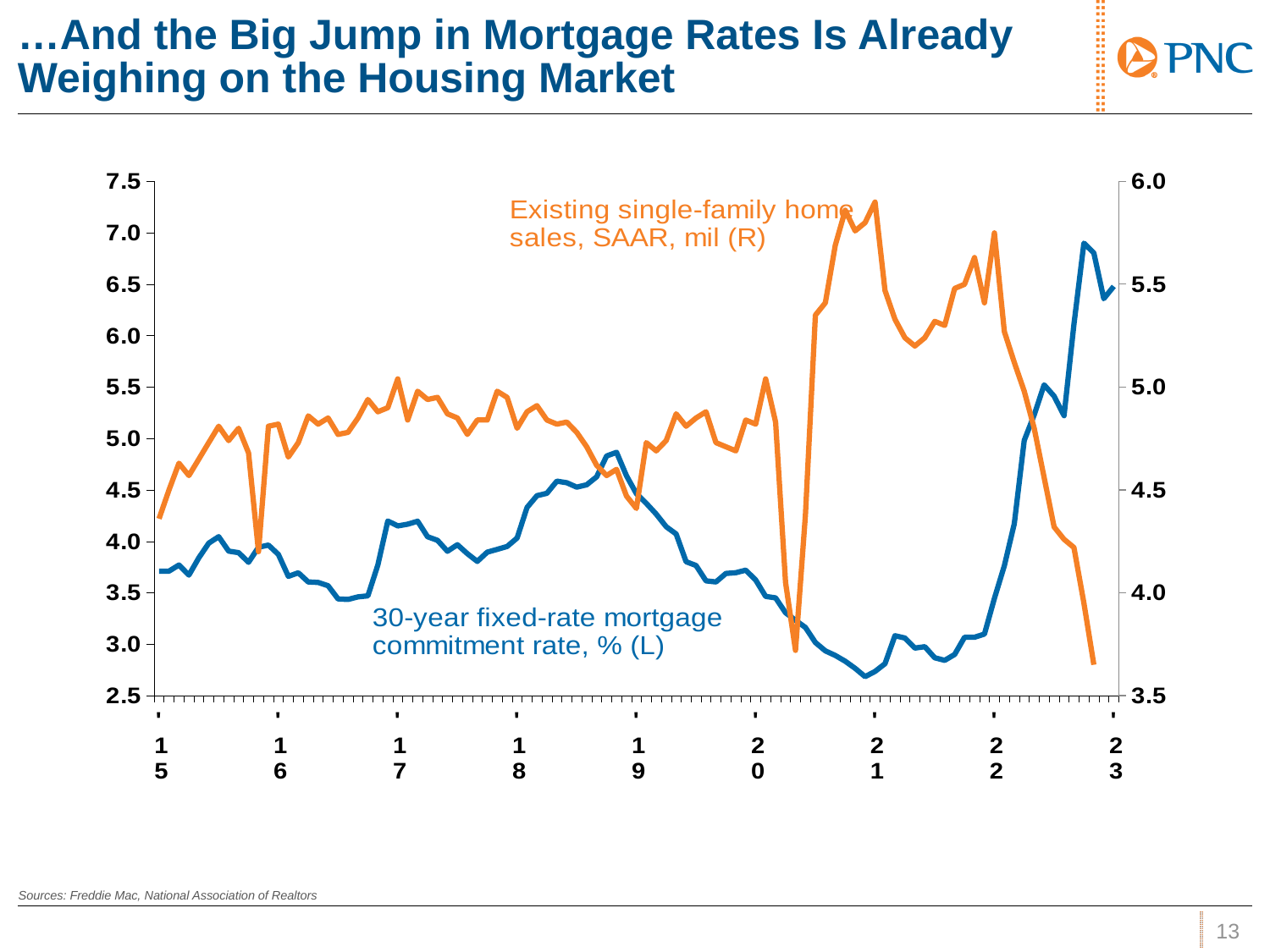
Is the peak value of existing single-family home sales in late 2020 greater or less than 5.5? greater Is the value for existing single-family home sales at the end of the chart (2023) greater or less than 4.0? less Does the 30-year fixed-rate mortgage commitment rate rise or fall between 2021 and 2023? rise Do existing single-family home sales rise or fall between 2021 and 2023? fall Is the 30-year fixed-rate mortgage commitment rate at the start of 2021 greater or less than 3.0? less How many data series are plotted on the chart? 2 How many year labels are shown on the x axis? 9 What kind of chart is shown on the slide? line chart Which series is plotted against the left axis? 30-year fixed-rate mortgage commitment rate, % (L) What colour is the line for existing single-family home sales? orange